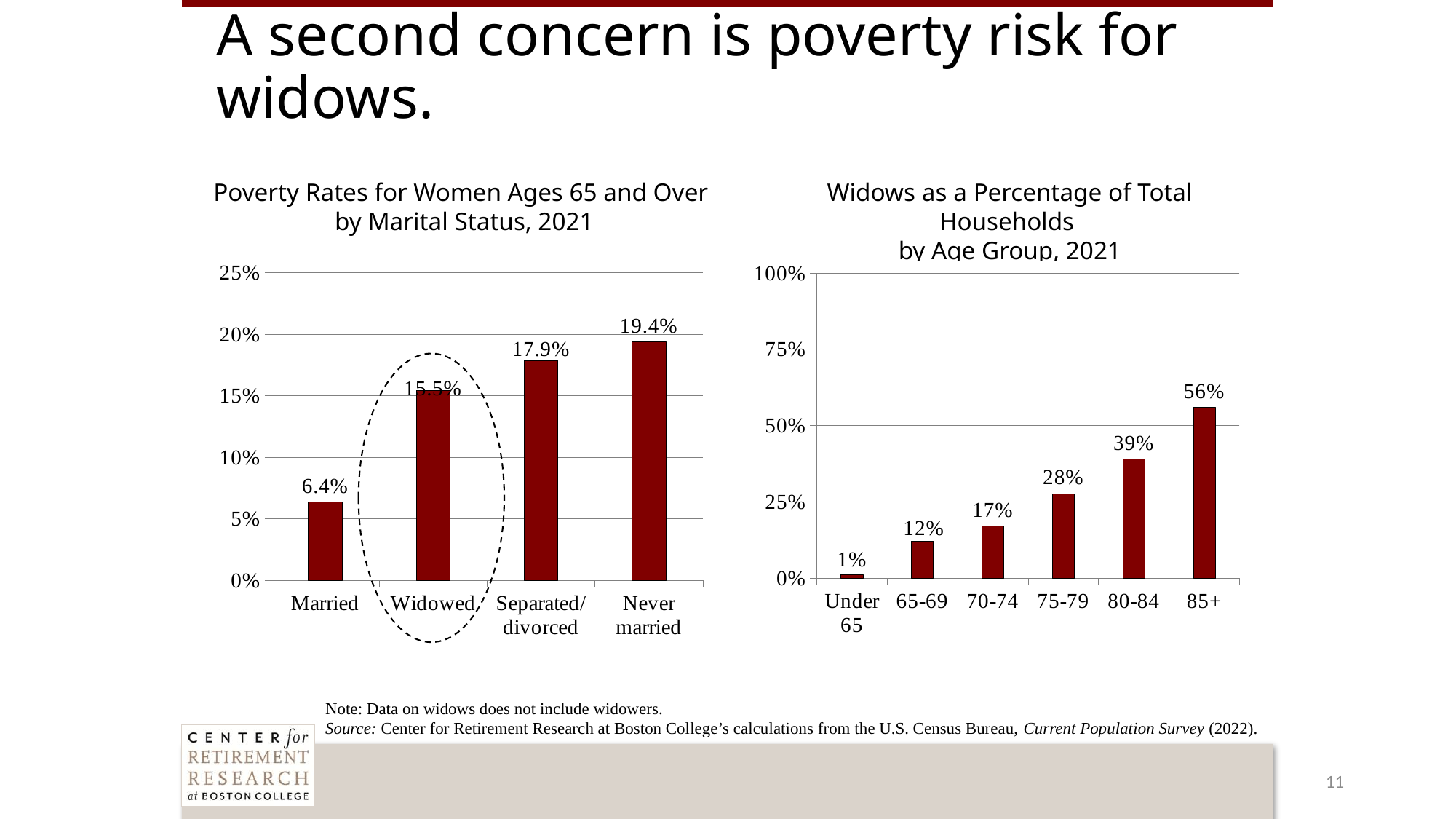
In the right chart (Widows as a Percentage of Total Households by Age Group, 2021), do the values rise or fall as age group increases? Rise In the left chart (Poverty Rates for Women Ages 65 and Over by Marital Status, 2021), what is the poverty rate for never married women? 19.4% In the left chart (Poverty Rates for Women Ages 65 and Over by Marital Status, 2021), which marital status has the highest poverty rate? Never married In the right chart (Widows as a Percentage of Total Households by Age Group, 2021), what percentage of households are widows in the 85+ age group? 56% In the right chart (Widows as a Percentage of Total Households by Age Group, 2021), what is the value for the 75-79 age group? 28% In the left chart (Poverty Rates for Women Ages 65 and Over by Marital Status, 2021), what is the poverty rate for married women? 6.4% What kind of chart is the right chart (Widows as a Percentage of Total Households by Age Group, 2021)? Bar chart In the right chart (Widows as a Percentage of Total Households by Age Group, 2021), what is the difference between the values for the 80-84 and 65-69 age groups? 27% In the left chart (Poverty Rates for Women Ages 65 and Over by Marital Status, 2021), which marital status has the lowest poverty rate? Married In the left chart (Poverty Rates for Women Ages 65 and Over by Marital Status, 2021), how many marital status categories are shown? 4 In the right chart (Widows as a Percentage of Total Households by Age Group, 2021), which age group has the lowest value? Under 65 In the left chart (Poverty Rates for Women Ages 65 and Over by Marital Status, 2021), what is the difference between the poverty rates for separated/divorced and married women? 11.5%